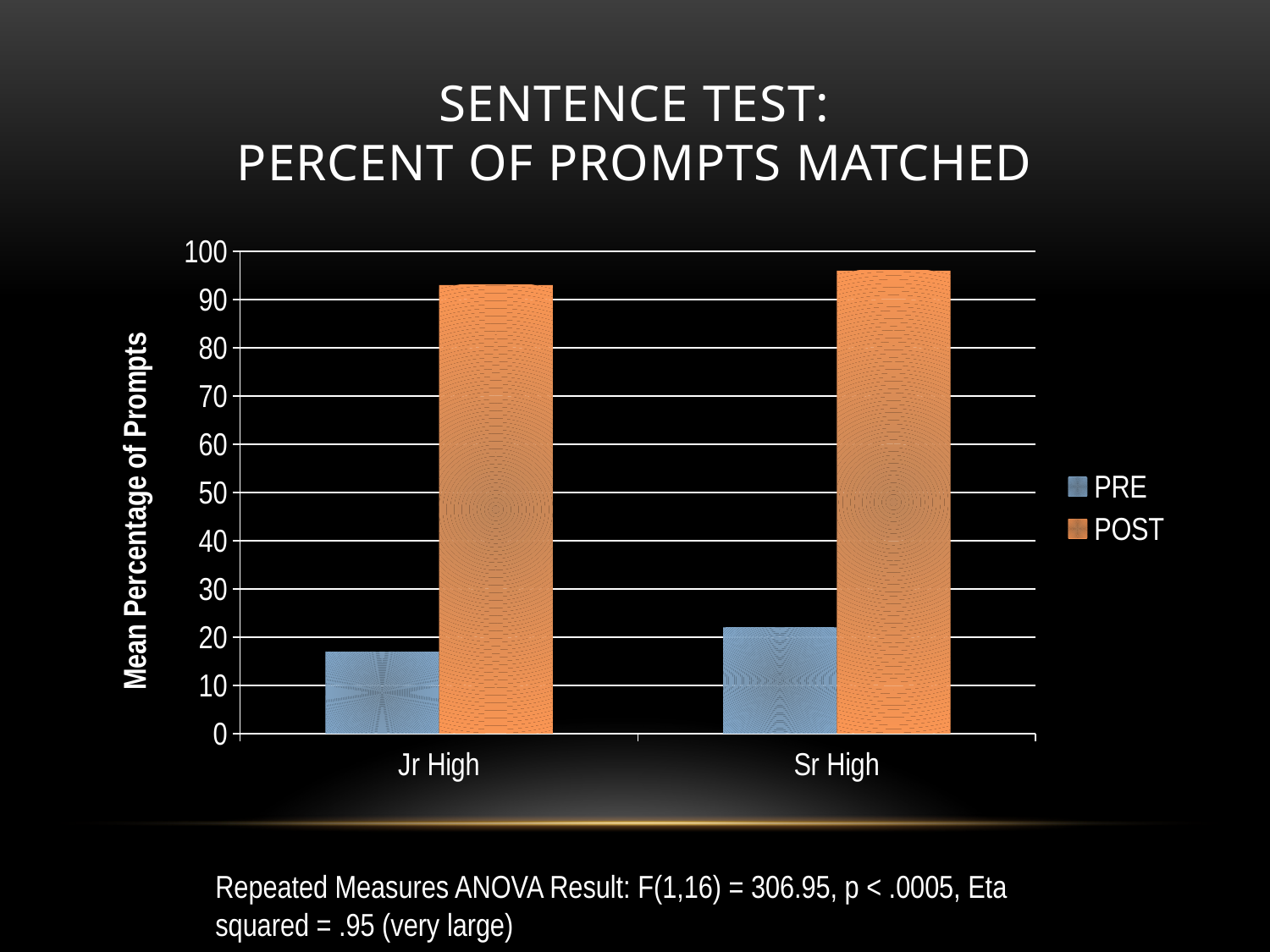
Is the PRE value for Sr High greater or less than 20? greater What kind of chart is shown on the slide? bar chart Which category has the higher PRE value, Jr High or Sr High? Sr High What is the y-axis title of the chart? Mean Percentage of Prompts What are the two series named in the legend? PRE and POST Is the PRE value for Jr High greater or less than 20? less How many categories are shown on the x axis? 2 Is the POST value for Sr High greater or less than 90? greater Which bar in the chart is the lowest? Jr High PRE How many series does the legend list? 2 For Jr High, which is larger, the PRE value or the POST value? POST